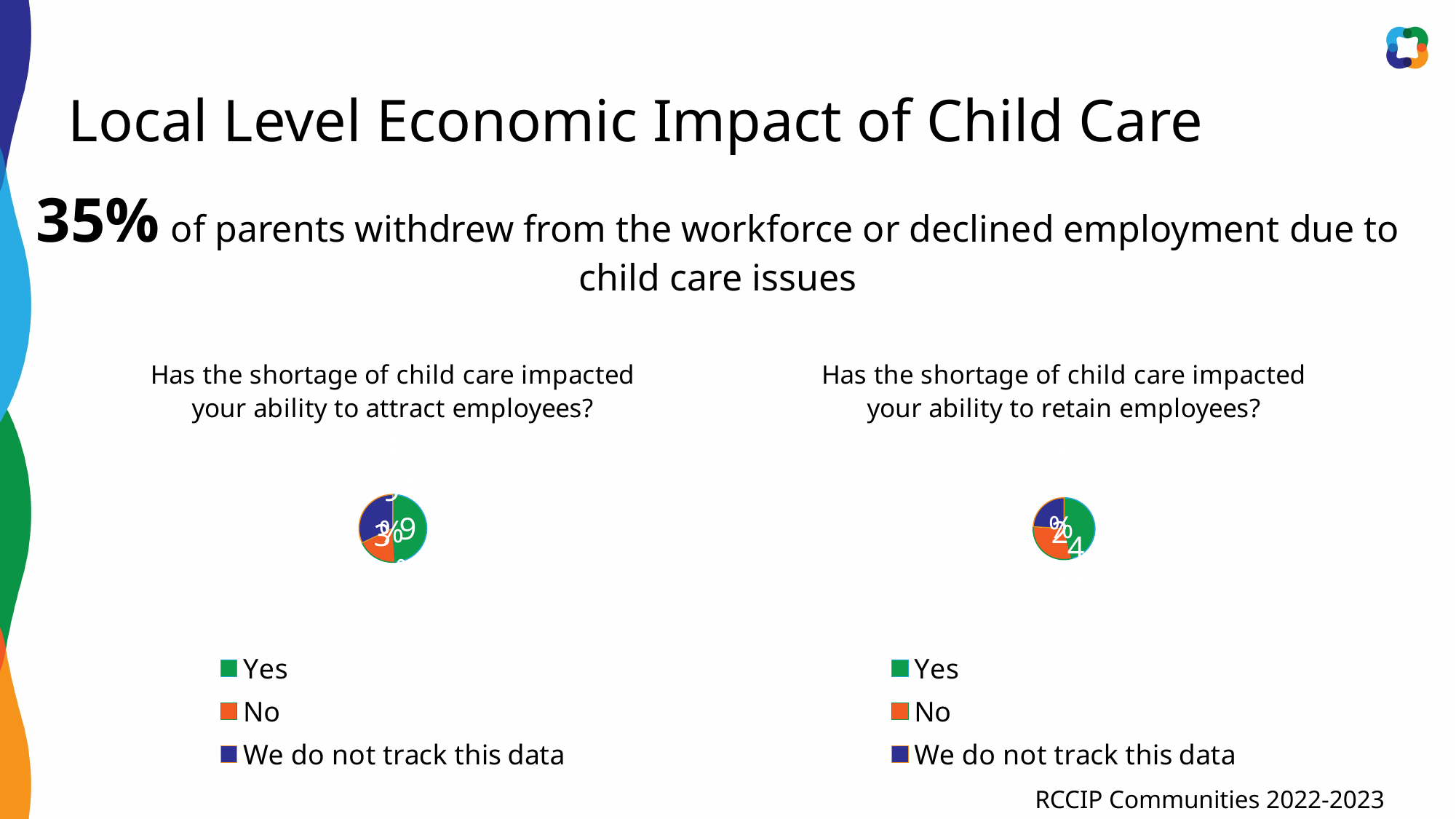
In the pie chart about retaining employees, which is larger: the "Yes" slice or the "We do not track this data" slice? Yes How many entries does the legend list for the pie chart about retaining employees? 3 In the pie chart about attracting employees, which is larger: the "Yes" slice or the "No" slice? Yes What kind of chart is used for "Has the shortage of child care impacted your ability to attract employees?"? Pie chart In the pie chart about retaining employees, which response has the largest slice? Yes How many pie charts are shown on the slide? 2 In the pie chart about attracting employees, which response has the largest slice? Yes What colour represents "We do not track this data" in the pie charts? Dark blue How many slices does the pie chart for "Has the shortage of child care impacted your ability to attract employees?" have? 3 What are the three legend entries for the pie chart about attracting employees? Yes, No, We do not track this data What kind of chart is used for "Has the shortage of child care impacted your ability to retain employees?"? Pie chart